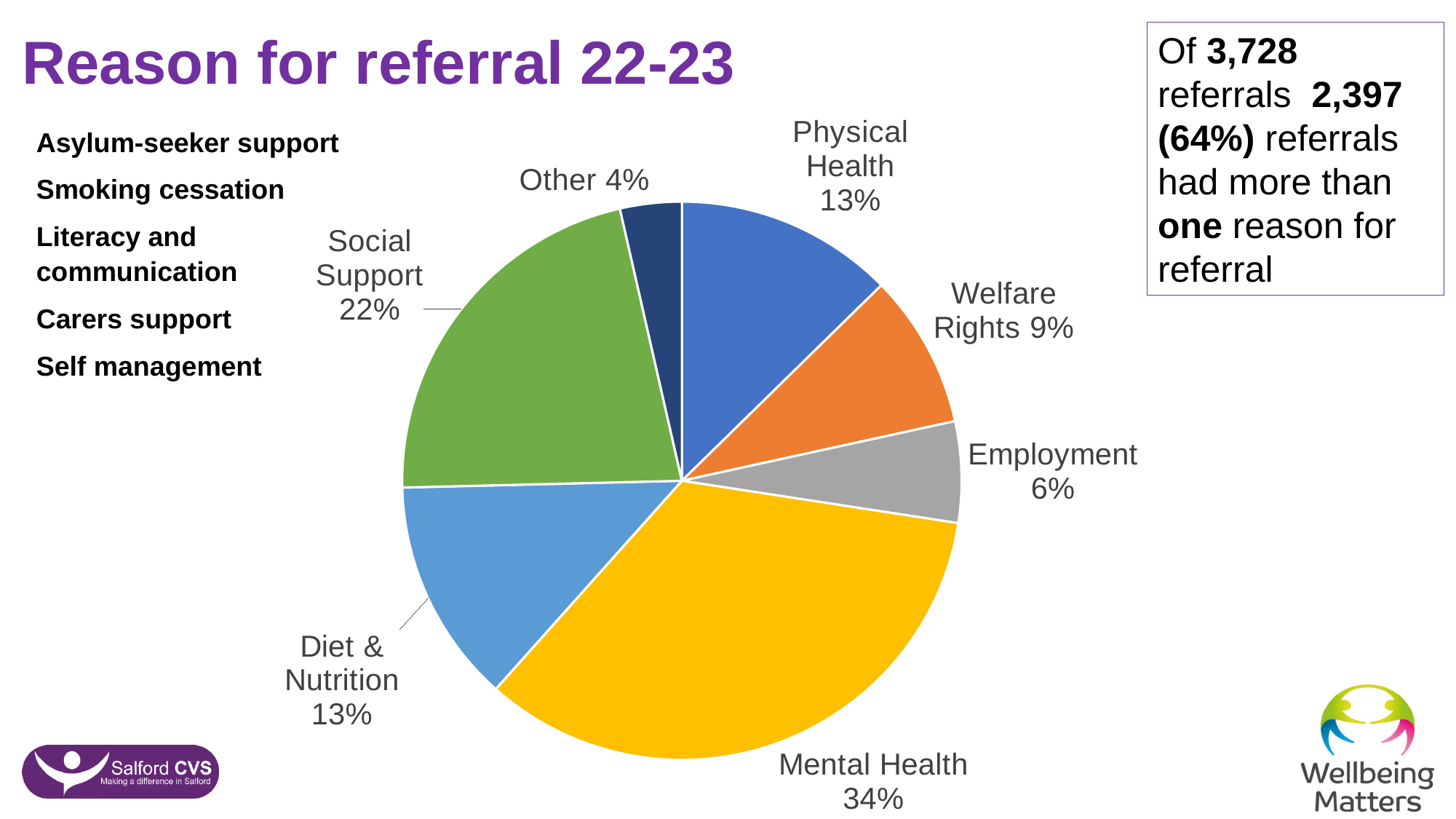
What share of referrals is for Social Support? 22% What is the title of the chart on the slide? Reason for referral 22-23 What share of referrals is for Mental Health? 34% Which is larger, the share for Welfare Rights or the share for Employment? Welfare Rights How many slices does the pie chart have? 7 What is the difference in percentage points between Mental Health and Social Support? 12 Which reason for referral has the largest slice of the pie? Mental Health What share of referrals is for Employment? 6% What share of referrals is for Welfare Rights? 9% Which reason for referral has the smallest slice of the pie? Other What kind of chart is shown on the slide? Pie chart What is the combined share of Physical Health and Diet & Nutrition? 26%